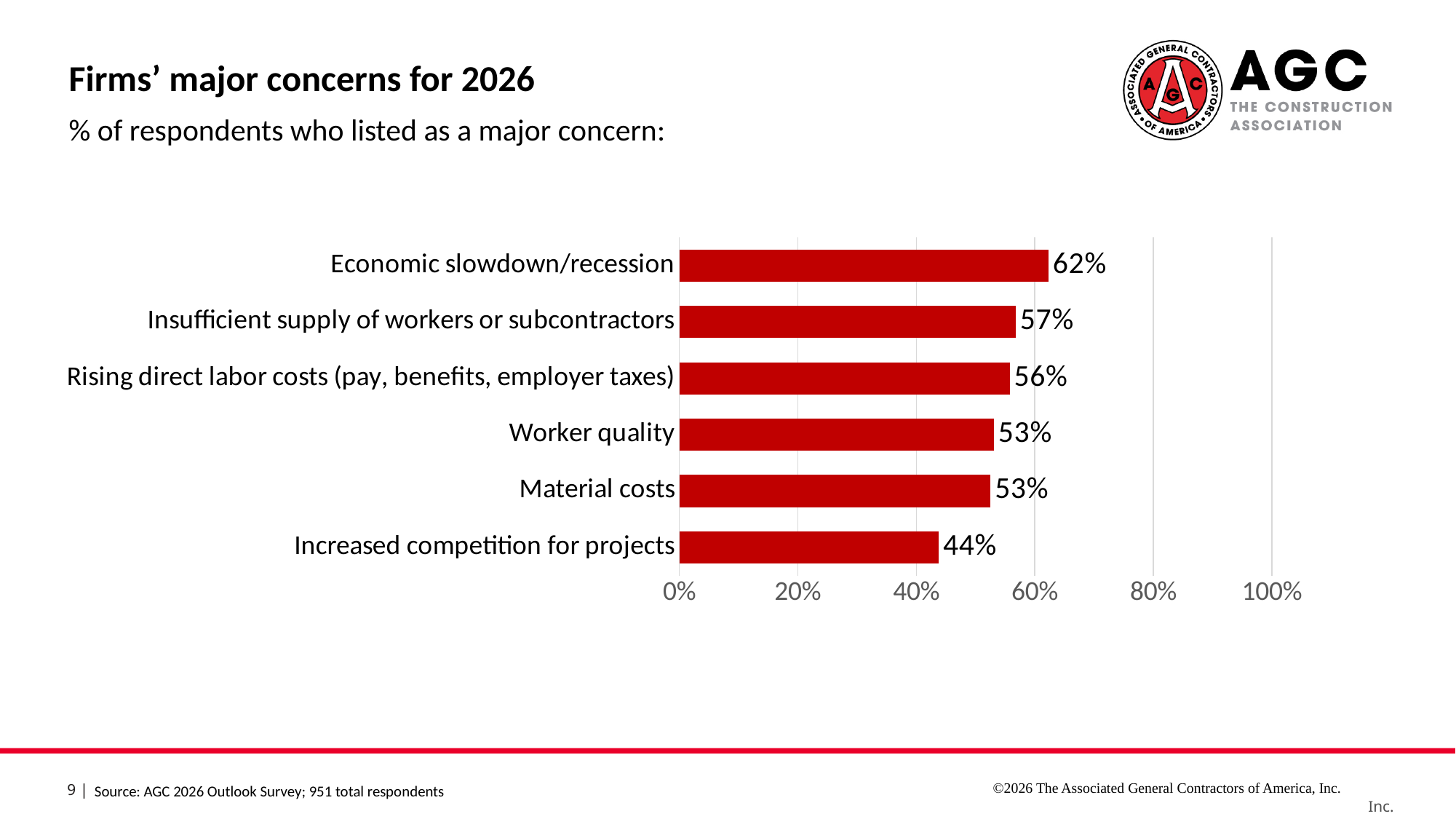
What percentage of respondents listed Material costs as a major concern? 53% How many concerns are shown in the chart? 6 Which concern has the highest percentage of respondents? Economic slowdown/recession What is the value for Insufficient supply of workers or subcontractors? 57% What is the value for Increased competition for projects? 44% What kind of chart is shown on the slide? Bar chart What percentage of respondents listed Economic slowdown/recession as a major concern? 62% Which concern has the lowest percentage of respondents? Increased competition for projects What is the difference between the values for Economic slowdown/recession and Increased competition for projects? 18% What is the title of the slide's chart? Firms' major concerns for 2026 Which is larger: the value for Rising direct labor costs (pay, benefits, employer taxes) or the value for Worker quality? Rising direct labor costs (pay, benefits, employer taxes) Is the value for Increased competition for projects greater or less than 60%? less